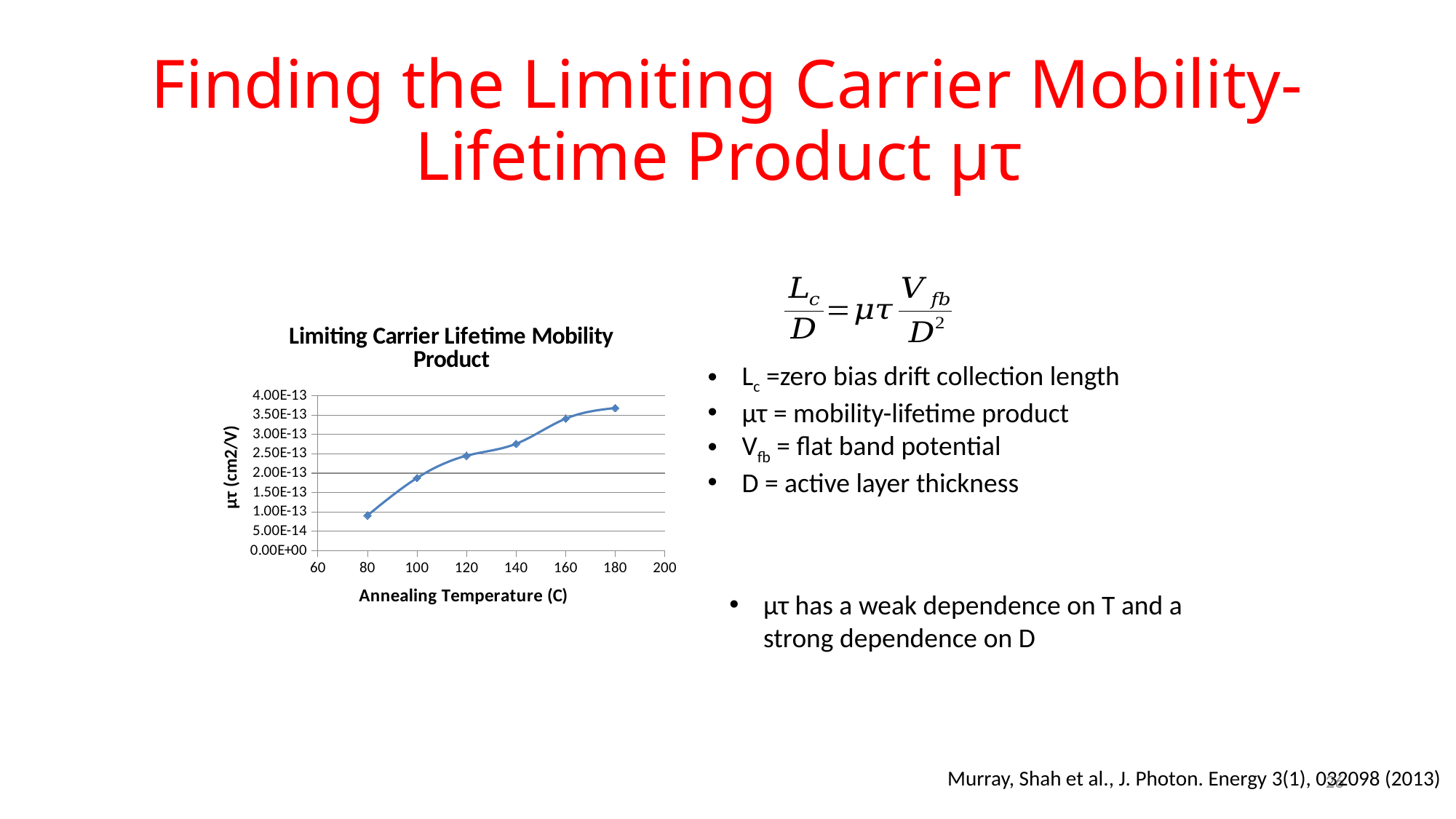
Which has the larger μτ value: an annealing temperature of 120 or 160? 160 Is the μτ value at an annealing temperature of 140 greater or less than 2.50E-13? greater What is the label of the x axis of the chart? Annealing Temperature (C) What is the title of the chart? Limiting Carrier Lifetime Mobility Product Is the μτ value at an annealing temperature of 180 greater or less than 3.50E-13? greater How many data points are plotted on the chart? 6 What kind of chart is shown on the slide? line chart Is the μτ value at an annealing temperature of 100 greater or less than 1.50E-13? greater Do the plotted μτ values rise or fall as annealing temperature increases? rise At which annealing temperature is the plotted μτ value lowest? 80 At which annealing temperature is the plotted μτ value highest? 180